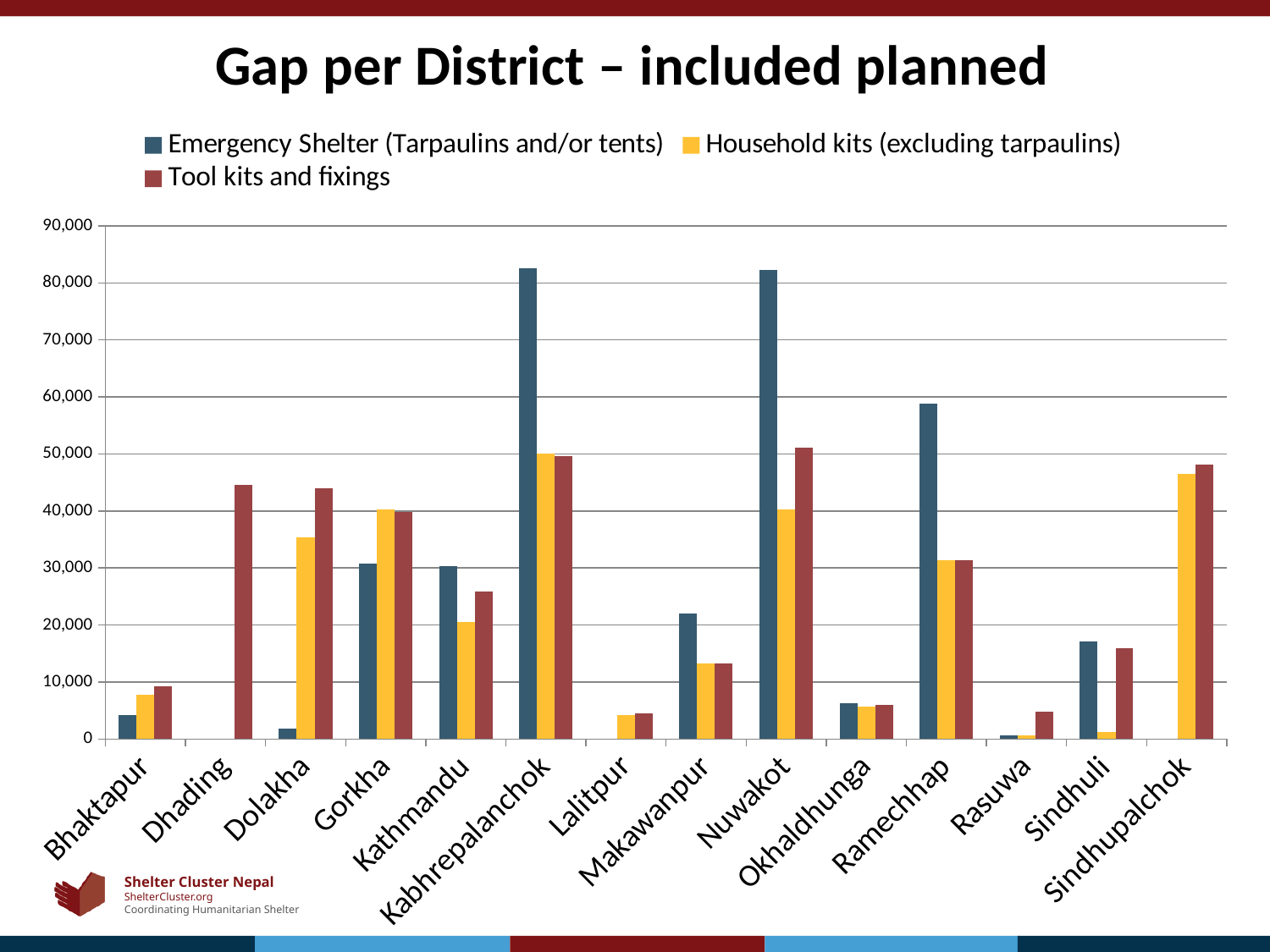
Is the Tool kits and fixings value for Dhading greater or less than 40,000? greater What kind of chart is shown on the slide? bar chart Is the Emergency Shelter (Tarpaulins and/or tents) value for Sindhuli greater or less than 20,000? less How many districts are shown on the x axis? 14 Which district has the highest value for Household kits (excluding tarpaulins)? Kabhrepalanchok Is the Household kits (excluding tarpaulins) value for Dolakha greater or less than 30,000? greater How many series does the legend list? 3 What is the title of the chart? Gap per District – included planned Which is larger: the Household kits (excluding tarpaulins) value for Gorkha or for Dolakha? Gorkha Which is larger: the Emergency Shelter (Tarpaulins and/or tents) value for Nuwakot or for Ramechhap? Nuwakot